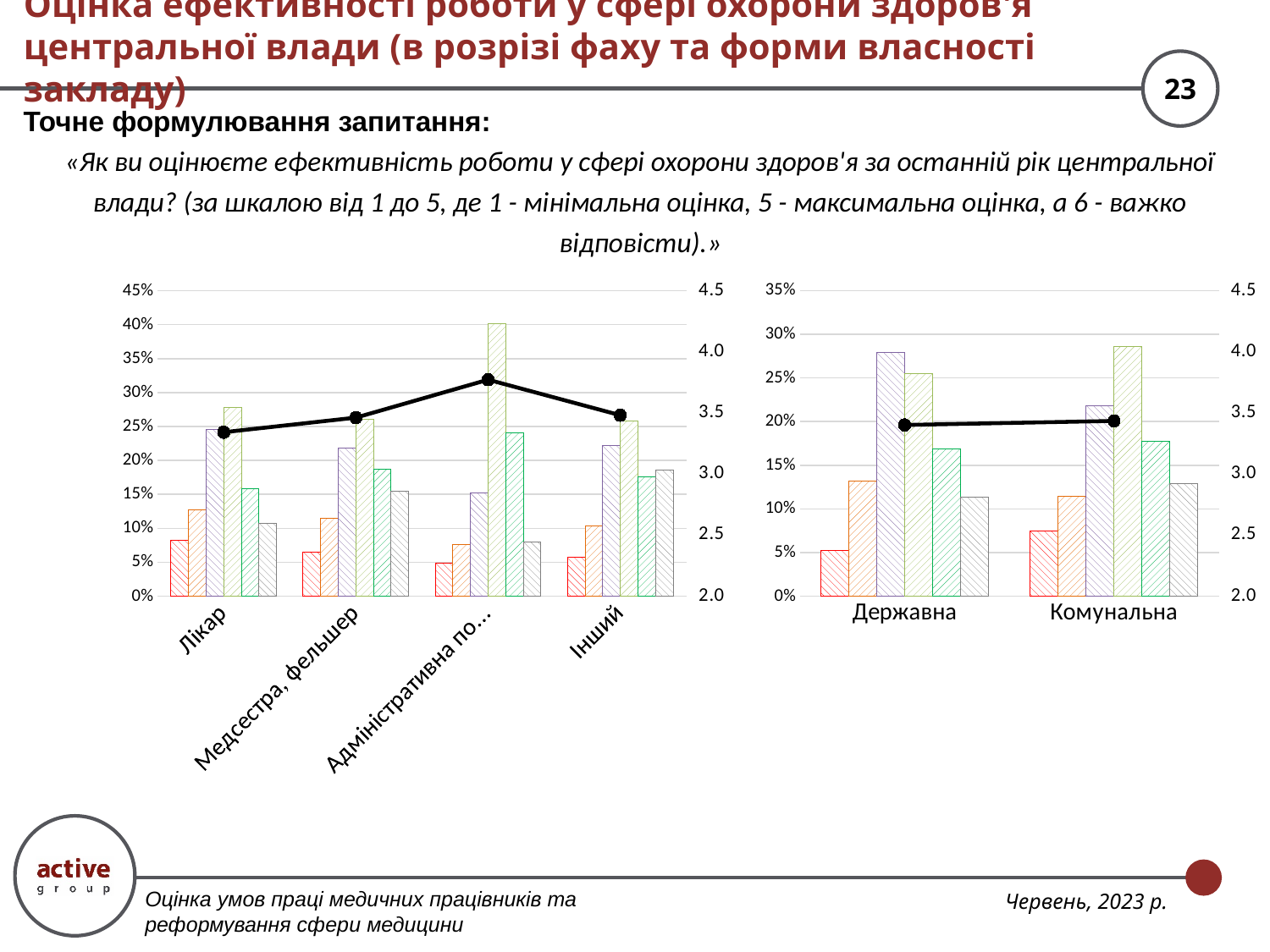
How many categories are shown on the x axis of the right chart? 2 What kind of chart is the right chart? bar chart with a line What is the highest tick on the left-hand percentage axis of the right chart? 35% In the right chart, is the line value for Державна greater or less than 3.5 on the right-hand axis? less How many bars are plotted for each category in the right chart? 6 How many categories are shown on the x axis of the left chart? 4 In the right chart, is the line value for Державна greater or less than 3.0 on the right-hand axis? greater In the left chart, for which category does the line reach its highest point? Адміністративна по... In the left chart, is the line value for Лікар greater or less than 3.5 on the right-hand axis? less What kind of chart is the left chart? bar chart with a line What is the highest tick on the left-hand percentage axis of the left chart? 45%